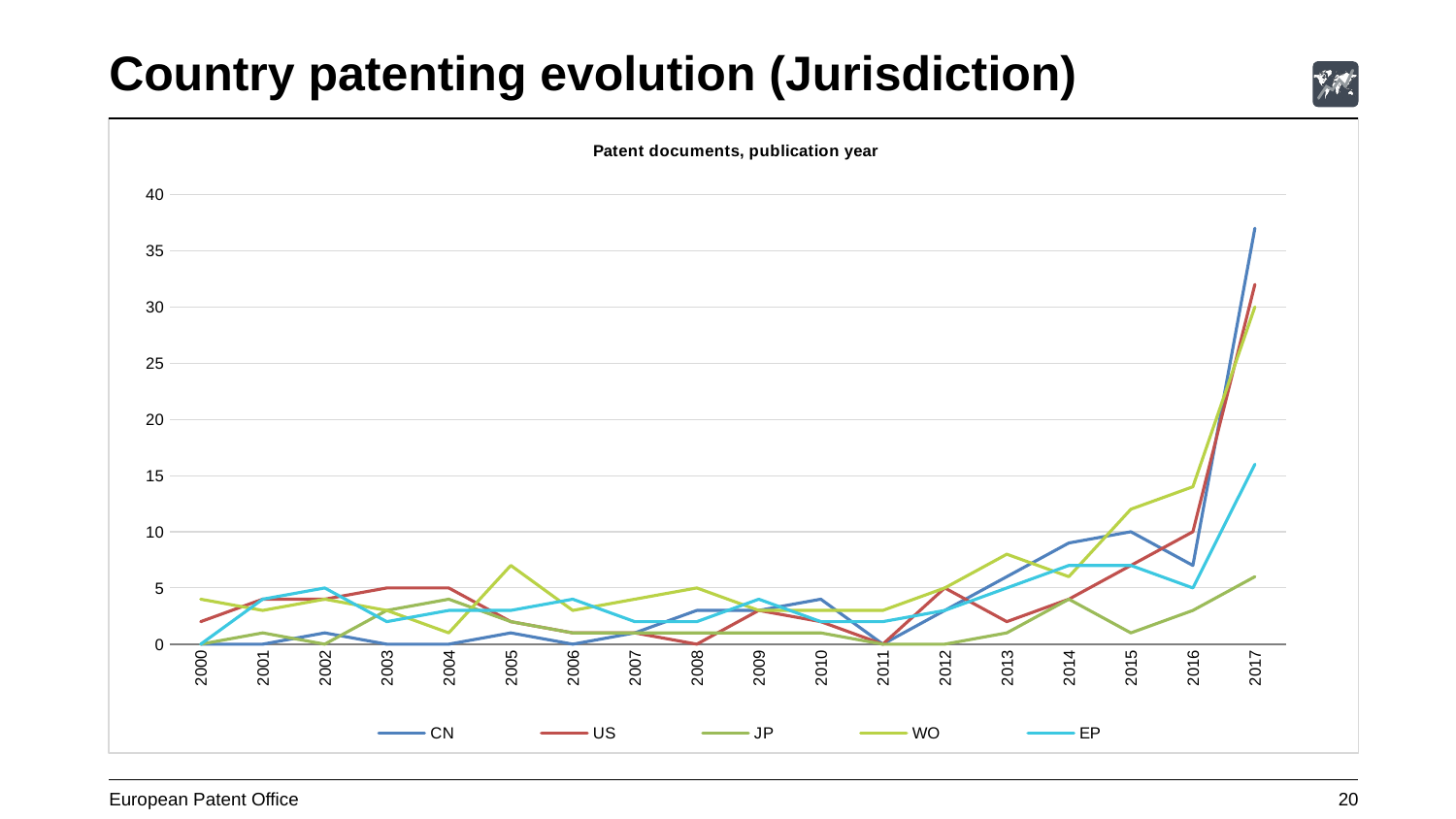
In 2017, which is larger, the value for CN or the value for EP? CN How many series does the legend list? 5 Is the value for CN in 2016 greater or less than 10? less What is the title of the chart? Patent documents, publication year Is the value for CN in 2017 greater or less than 30? greater Which series has the lowest value in 2017? JP What kind of chart is shown on the slide? line chart Does the CN series rise or fall from 2011 to 2017? rise Is the value for JP in 2017 greater or less than 10? less How many years are shown along the x axis? 18 Which series has the highest value in 2017? CN